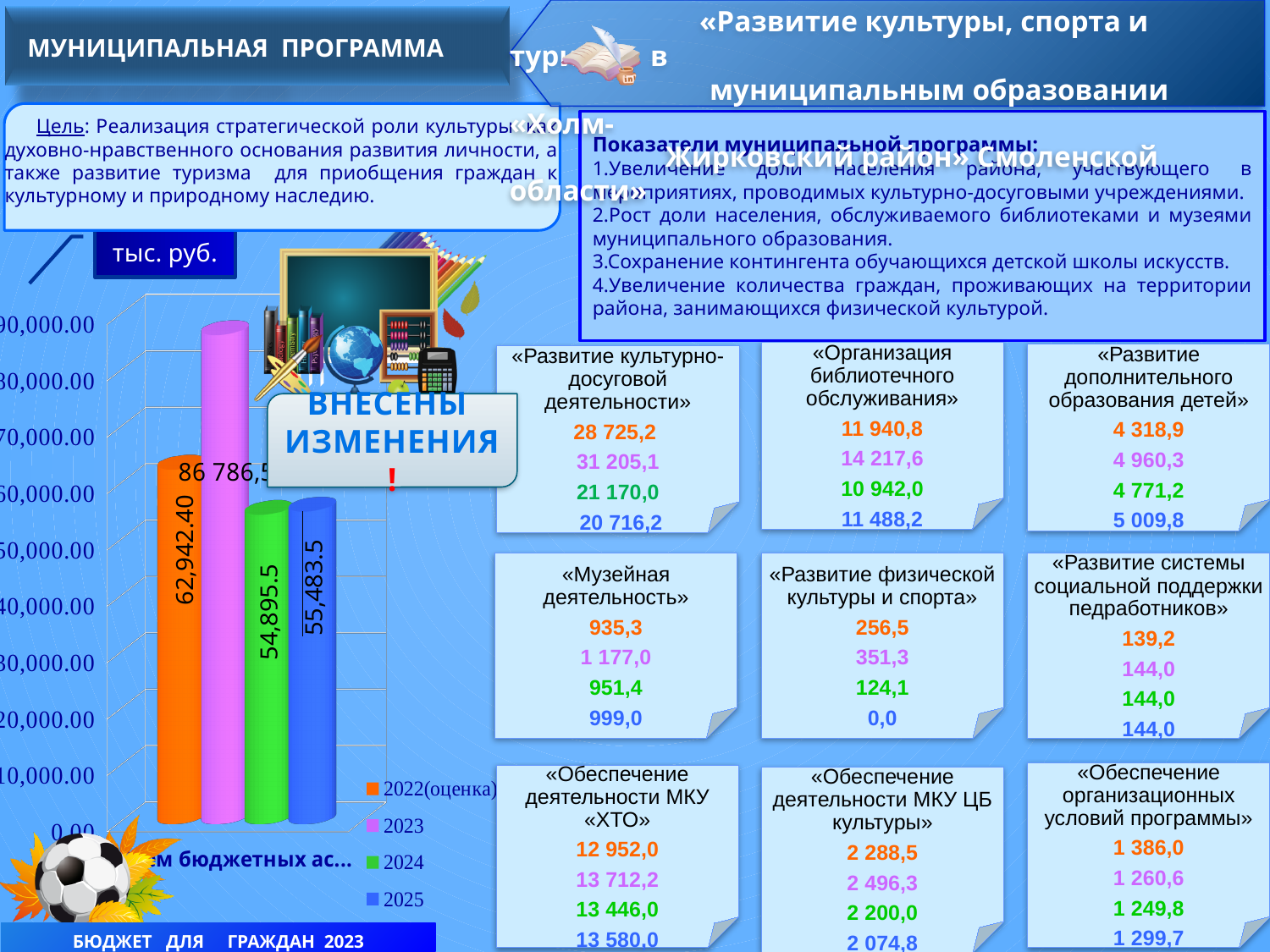
What is the value of the 2022(оценка) bar in the bar chart? 62,942.40 Which year has the highest bar in the chart? 2023 What is the value of the 2025 bar in the bar chart? 55,483.5 What unit label is shown above the chart? тыс. руб. How many series does the chart legend list? 4 What is the difference between the 2025 value and the 2024 value in the chart? 588.0 What is the difference between the 2022(оценка) value and the 2024 value in the chart? 8,046.90 Which year has the lowest bar in the chart? 2024 How many bars are plotted in the chart? 4 Which is larger in the chart, the value for 2024 or the value for 2025? 2025 What is the value of the 2024 bar in the bar chart? 54,895.5 What type of chart is shown on the slide? bar chart